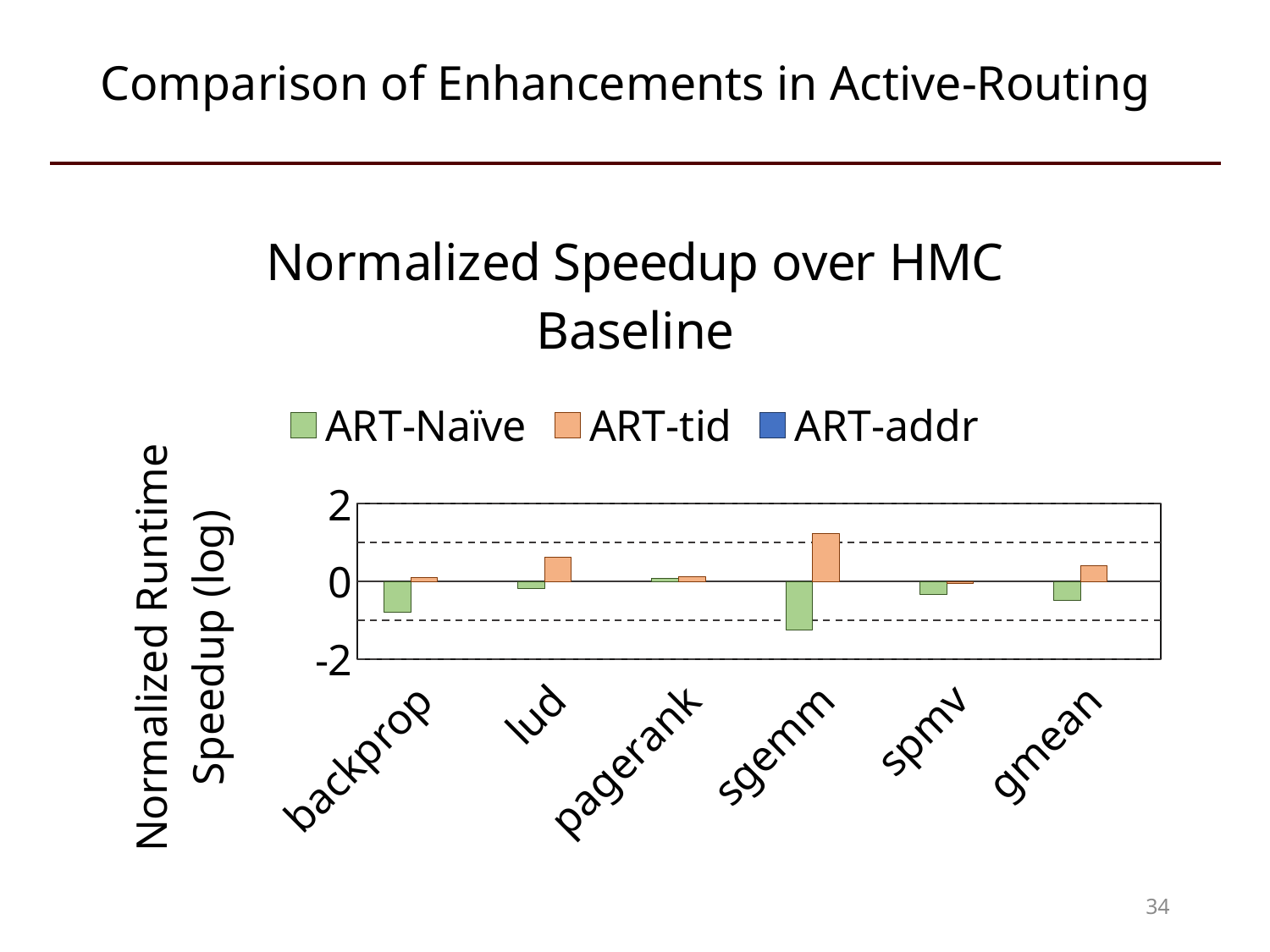
What kind of chart is shown on the slide? bar chart Which category has the lowest ART-Naïve value? sgemm Is the ART-Naïve value for backprop greater or less than 0? less Which category has the highest ART-tid value? sgemm For backprop, which series has the larger value, ART-Naïve or ART-tid? ART-tid How many categories are shown on the x axis? 6 Which is larger, the ART-tid value for lud or the ART-tid value for gmean? lud How many series does the legend list? 3 Is the ART-tid value for lud greater or less than 0? greater Which is lower, the ART-Naïve value for backprop or the ART-Naïve value for sgemm? sgemm What is the title of the chart? Normalized Speedup over HMC Baseline What colour represents the ART-Naïve series in the legend? green